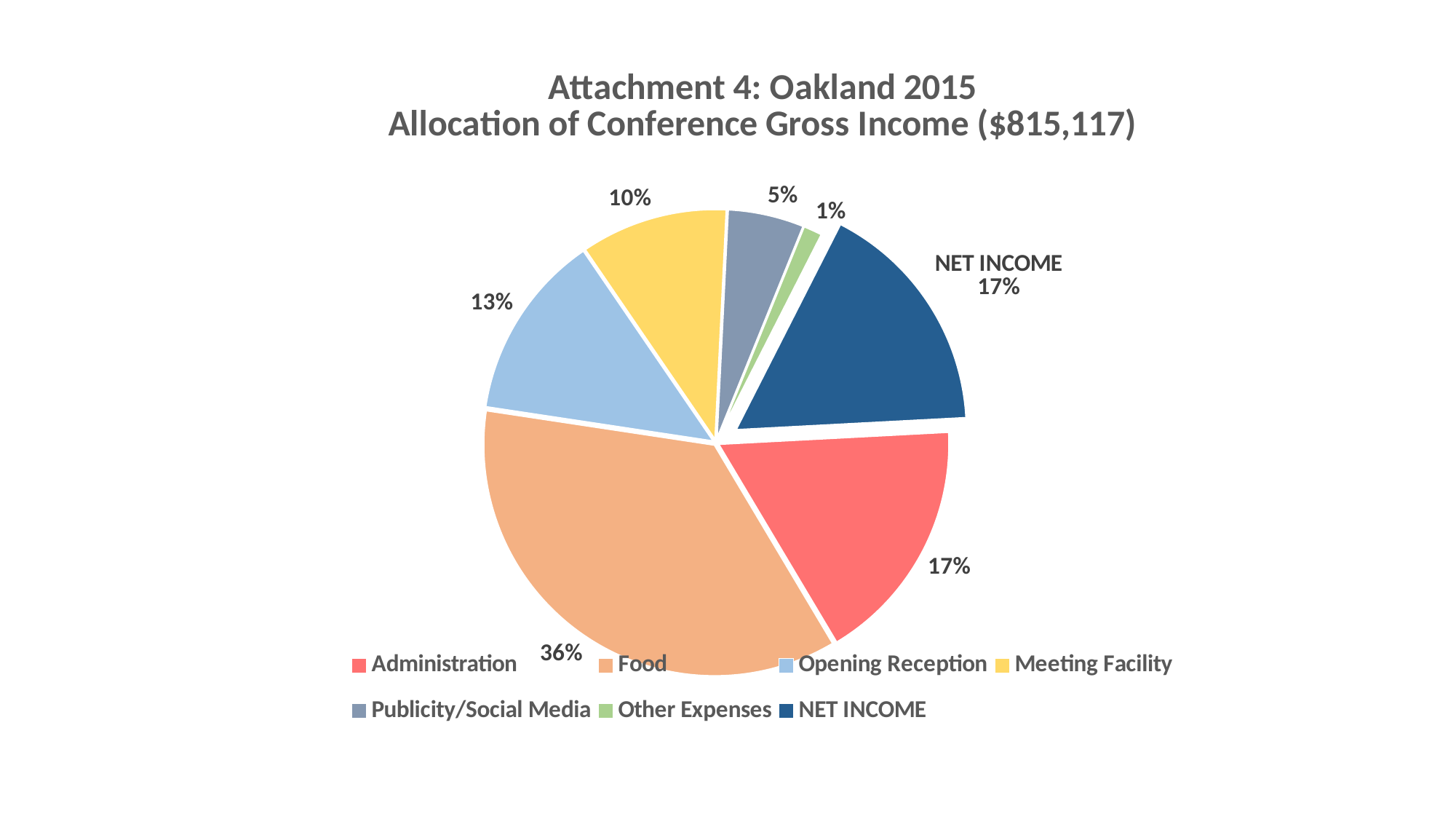
What share is allocated to Opening Reception? 13% How many percentage points larger is the Food share than the Administration share? 19 What type of chart is shown on the slide? Pie chart What share of conference gross income is allocated to Food? 36% What share goes to Publicity/Social Media? 5% Which is larger, the Opening Reception share or the Meeting Facility share? Opening Reception What total gross income amount is stated in the chart title? $815,117 How many categories does the legend list? 7 Which category has the largest slice of the pie? Food Which category has the smallest slice of the pie? Other Expenses